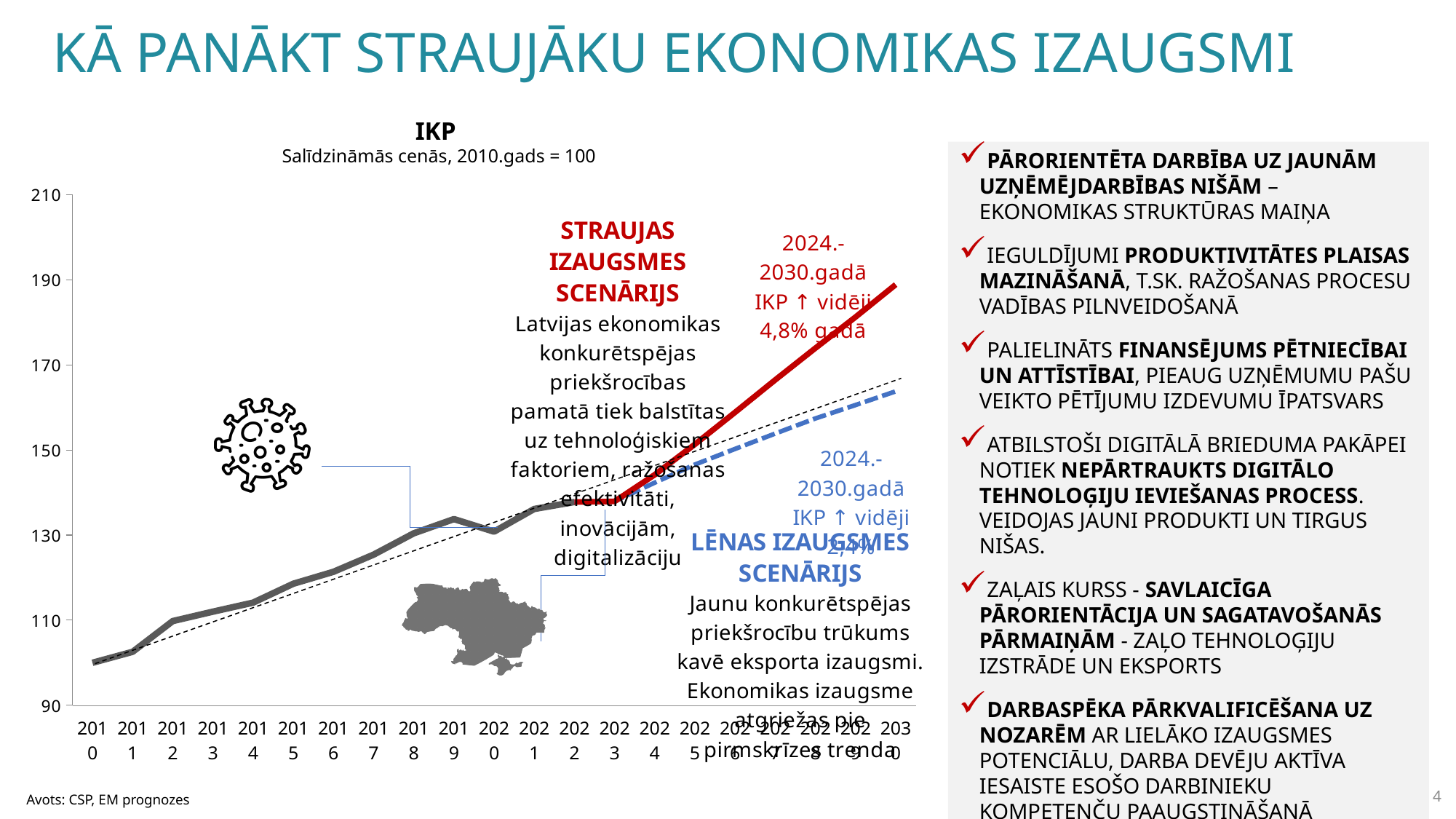
What base year and index value does the chart subtitle state? 2010.gads = 100 Is the value of the grey line in 2015 greater or less than 110? greater Is the value of the red fast growth scenario line in 2030 greater or less than 170? greater Is the value of the blue dashed slow growth scenario line in 2030 greater or less than 170? less According to the red annotation, what is the average annual IKP growth in 2024–2030 under the fast growth scenario (Straujas izaugsmes scenārijs)? 4,8% What is the title of the chart? IKP What kind of chart is shown on the slide? line chart In 2030, which scenario line is higher: the red fast growth scenario or the blue dashed slow growth scenario? the red fast growth scenario How many years are labelled on the x axis of the chart? 21 Does the grey IKP line generally rise or fall from 2010 to 2019? rise According to the blue annotation, what is the average annual IKP growth in 2024–2030 under the slow growth scenario (Lēnas izaugsmes scenārijs)? 2,4%